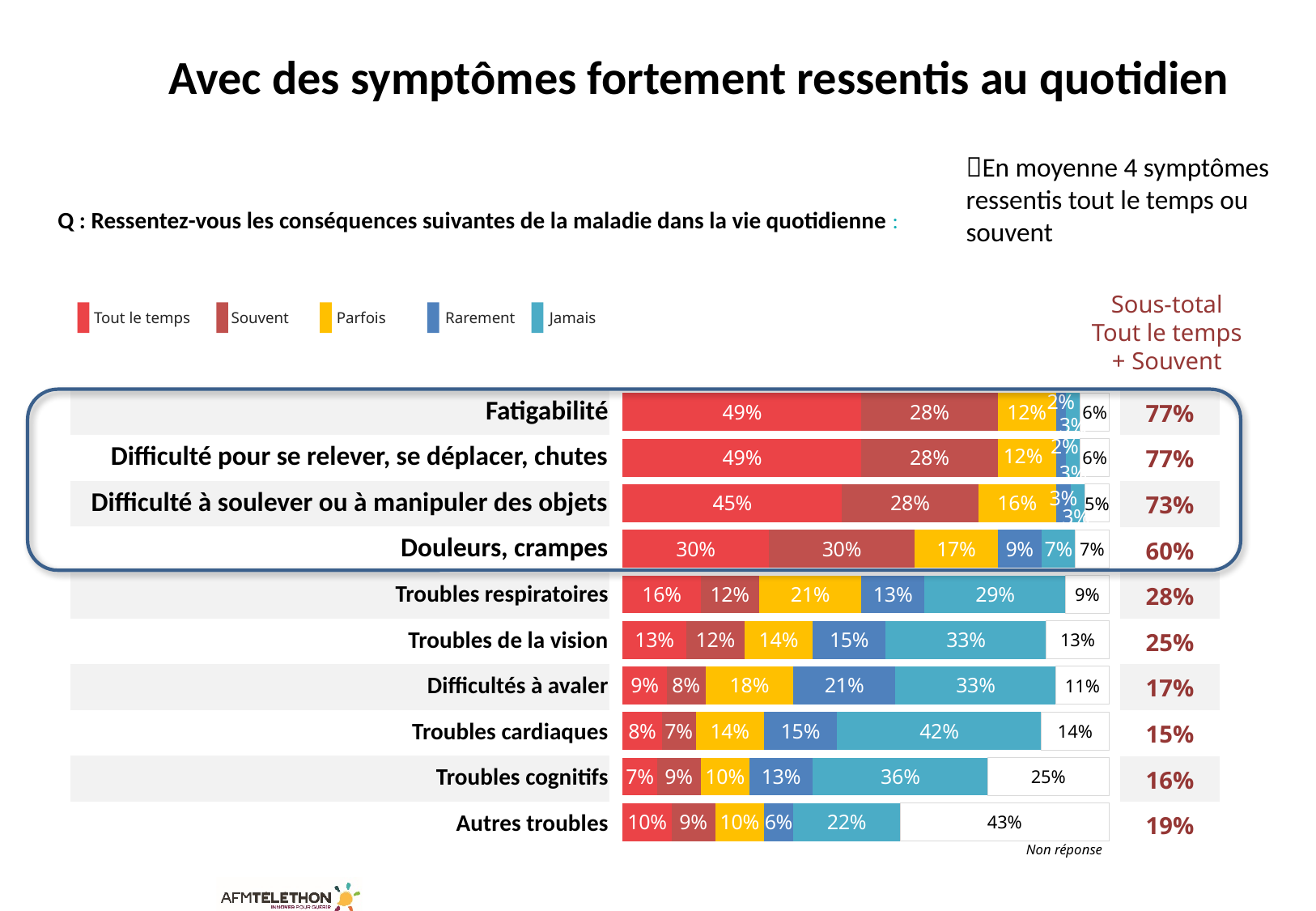
How many categories (symptoms) are shown in the chart? 10 What is the difference between the "Tout le temps" values for Douleurs, crampes and Troubles de la vision? 17% What is the "Jamais" value for Troubles cardiaques? 42% How many series does the legend list? 5 Which category has the lowest "Tout le temps" value? Troubles cognitifs What kind of chart is shown on the slide? Stacked bar chart What percentage of respondents answered "Tout le temps" for Fatigabilité? 49% What is the "Non réponse" value for Autres troubles? 43% Which is larger: the "Rarement" value for Difficultés à avaler or for Troubles de la vision? Difficultés à avaler What is the sous-total "Tout le temps + Souvent" for Douleurs, crampes? 60% Which category has the highest "Jamais" value? Troubles cardiaques What is the "Parfois" value for Troubles respiratoires? 21%